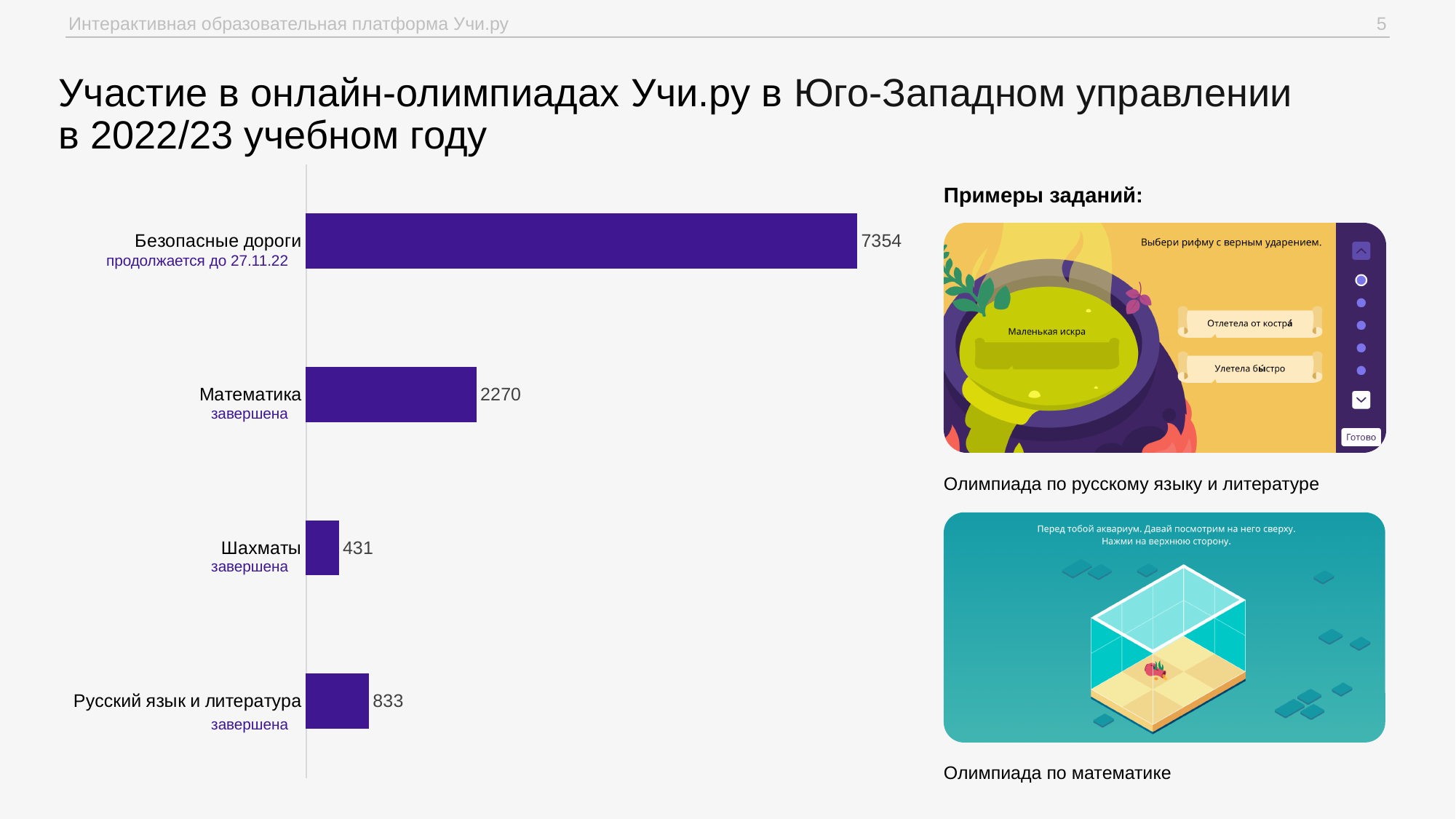
How many categories are shown in the chart? 4 Which is larger, the value for Математика or the value for Русский язык и литература? Математика What is the value for Шахматы? 431 What is the value for Безопасные дороги? 7354 What is the value for Русский язык и литература? 833 What is the value for Математика? 2270 What status is shown under the Безопасные дороги bar label? продолжается до 27.11.22 Which category has the lowest value? Шахматы Which category has the highest value? Безопасные дороги What is the difference between the values for Безопасные дороги and Математика? 5084 What kind of chart is shown on the slide? Bar chart What is the difference between the values for Русский язык и литература and Шахматы? 402